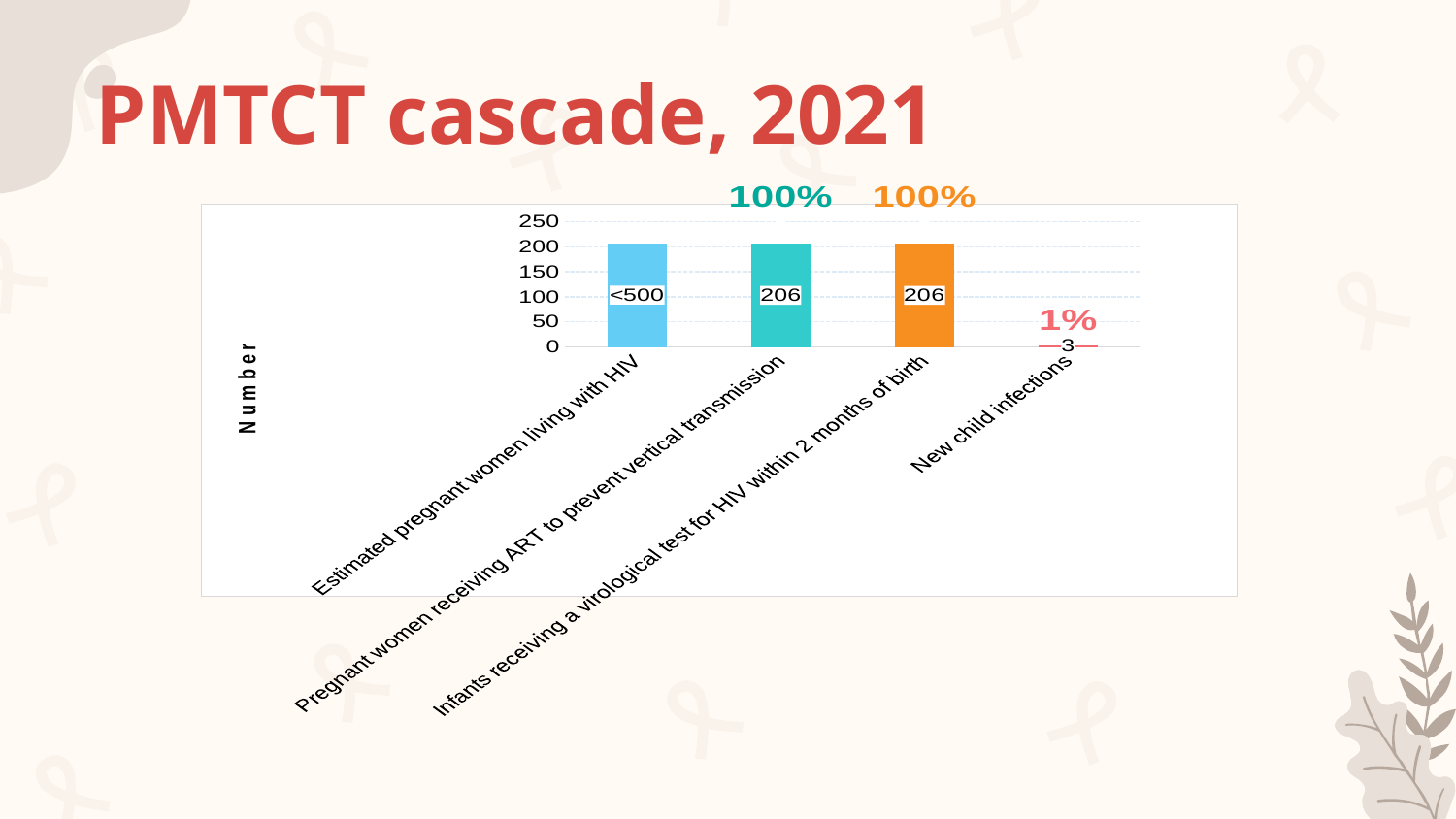
What kind of chart is shown on the slide? bar chart How many categories are shown on the x axis? 4 What label is printed on the bar for Estimated pregnant women living with HIV? <500 What is the value shown for New child infections? 3 Which is larger: the value for Infants receiving a virological test for HIV within 2 months of birth or the value for New child infections? Infants receiving a virological test for HIV within 2 months of birth What is the value shown for Pregnant women receiving ART to prevent vertical transmission? 206 What percentage is annotated above the New child infections bar? 1% Which category has the lowest value? New child infections What is the title of the y axis? Number Is the value for New child infections greater or less than 50? less What is the value shown for Infants receiving a virological test for HIV within 2 months of birth? 206 What is the difference between the value for Pregnant women receiving ART to prevent vertical transmission and the value for New child infections? 203